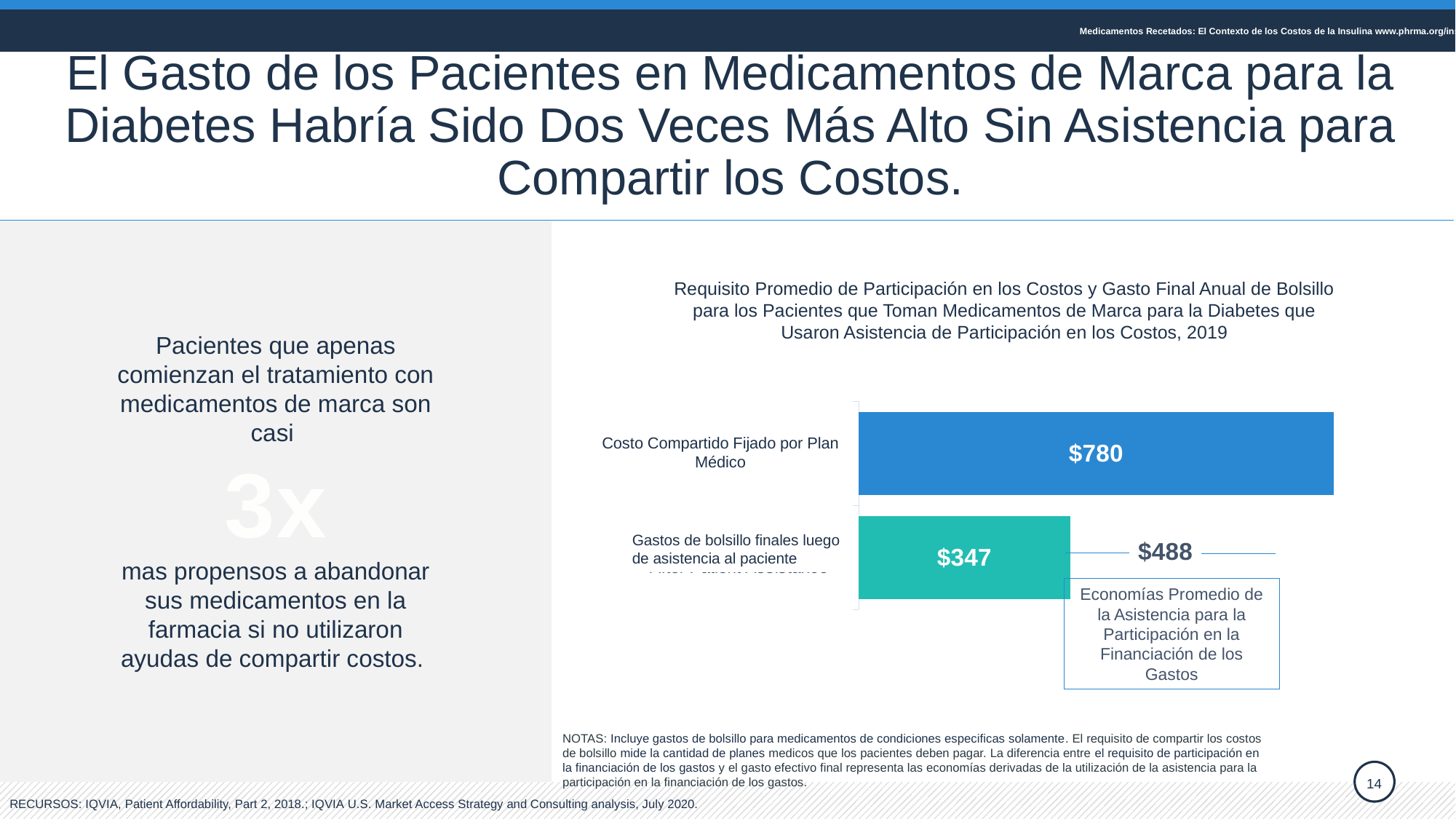
What colour is the bar for Costo Compartido Fijado por Plan Médico? Blue What is the value for Costo Compartido Fijado por Plan Médico? $780 What is the value for Gastos de bolsillo finales luego de asistencia al paciente? $347 What value is labelled as Economías Promedio de la Asistencia para la Participación en la Financiación de los Gastos? $488 How many bars are plotted in the chart? 2 Which is larger: Costo Compartido Fijado por Plan Médico or Gastos de bolsillo finales luego de asistencia al paciente? Costo Compartido Fijado por Plan Médico Which category has the lowest value? Gastos de bolsillo finales luego de asistencia al paciente What year does the chart title say the data is for? 2019 Which category has the highest value? Costo Compartido Fijado por Plan Médico What kind of chart is shown on the slide? Bar chart